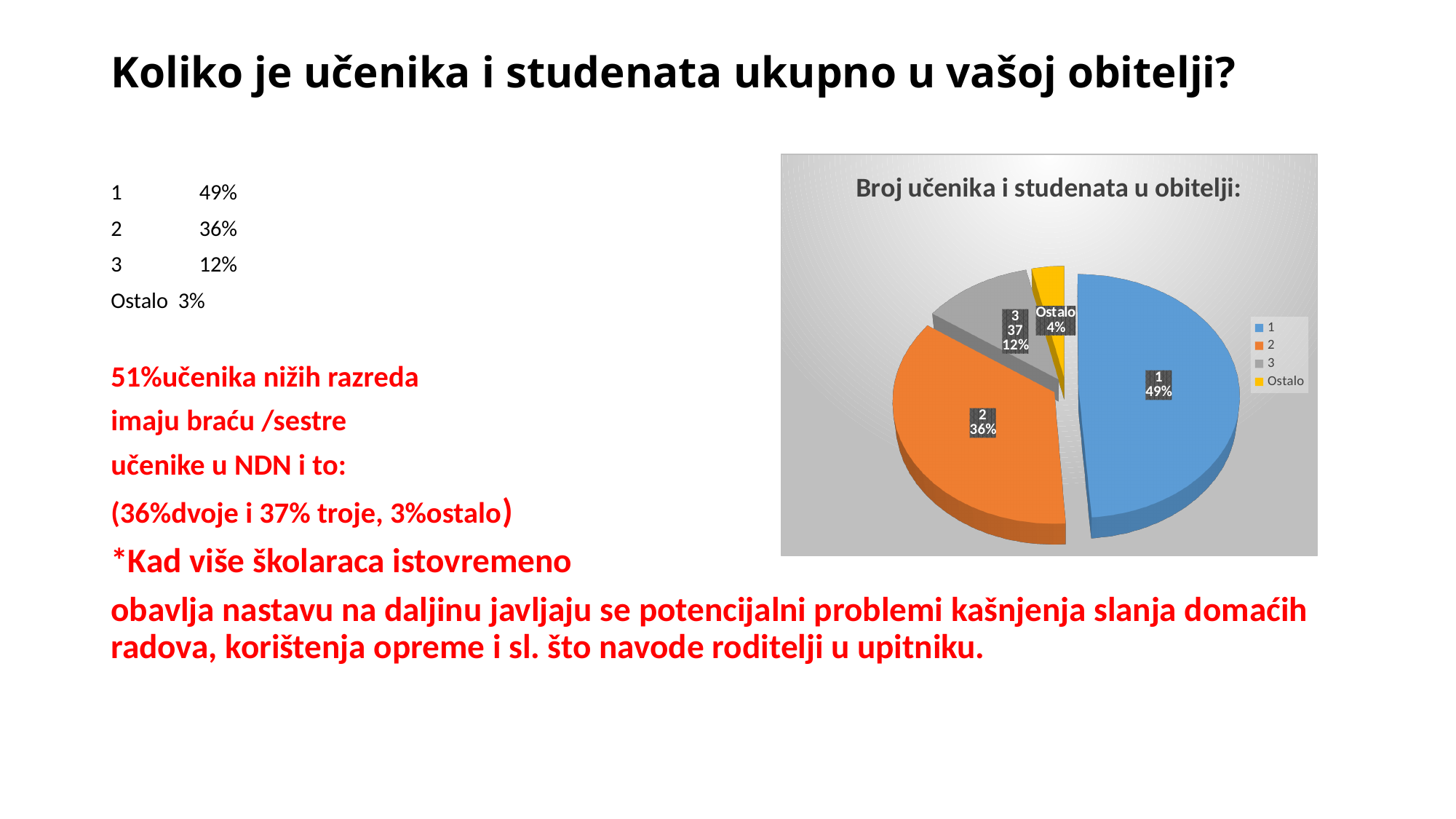
What is the title of the chart? Broj učenika i studenata u obitelji: Which slice is larger in the pie chart, 2 or 3? 2 How many slices does the pie chart have? 4 What percentage does the slice labelled 3 show in the pie chart? 12% What kind of chart is shown on the slide? pie chart What percentage does the slice labelled 2 show in the pie chart? 36% Which category has the largest slice in the pie chart? 1 How many entries does the chart legend list? 4 Which category has the smallest slice in the pie chart? Ostalo What percentage does the slice labelled 1 show in the pie chart? 49% What percentage does the slice labelled Ostalo show in the pie chart? 4% What is the difference in percentage points between the slices labelled 1 and 2? 13